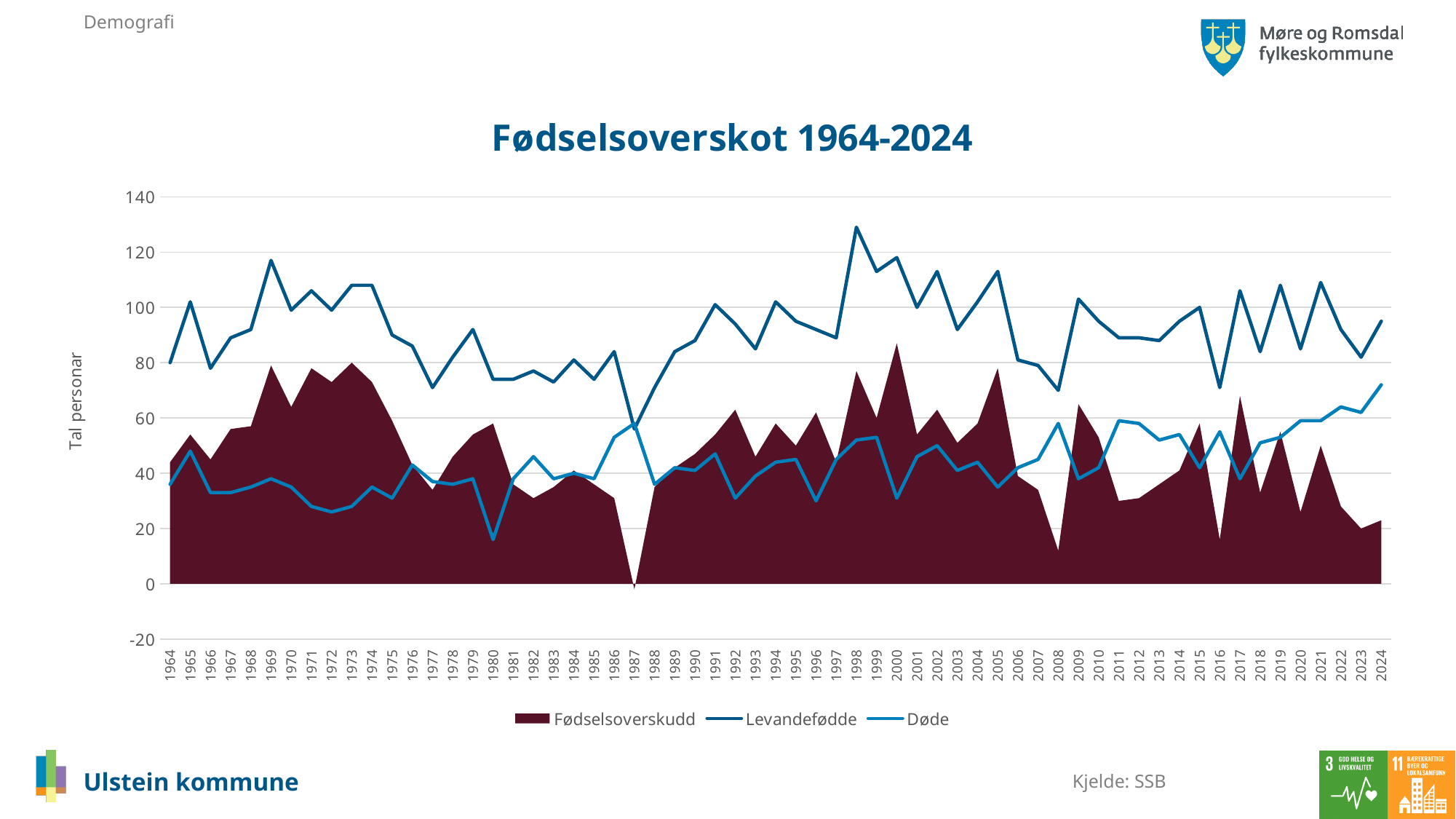
Which is larger, the Døde value in 1964 or the Døde value in 2024? 2024 In which year is the Levandefødde line at its lowest? 1987 What is the title of the chart? Fødselsoverskot 1964-2024 In which year is the Døde line at its lowest? 1980 Is the value for Levandefødde in 1977 greater or less than 80? less In which year is the Levandefødde line at its highest? 1998 Is the value for Levandefødde in 1998 greater or less than 120? greater Is the value for Døde in 1980 greater or less than 20? less In which year is the Døde line at its highest? 2024 What is the label on the vertical axis of the chart? Tal personar How many years are plotted along the x axis of the chart? 61 How many series does the chart legend list? 3